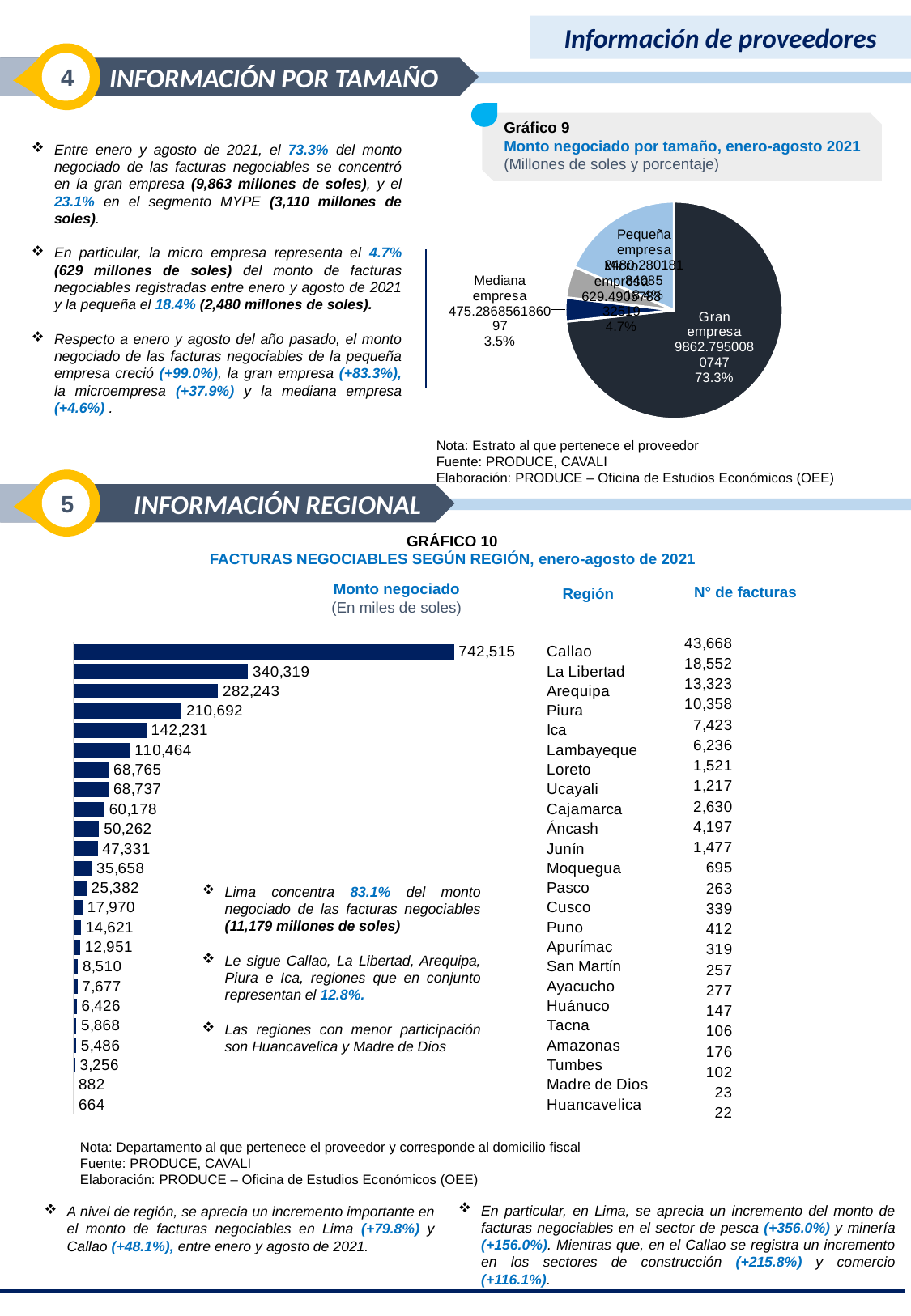
In Gráfico 9, which segment has the largest share? Gran empresa In Gráfico 10, which has a larger monto negociado, Piura or Ica? Piura In Gráfico 9, what percentage share does Mediana empresa have? 3.5% In Gráfico 10, which region has the lowest monto negociado? Huancavelica How many regions are shown in Gráfico 10? 24 In Gráfico 9, what percentage share does Gran empresa have? 73.3% In Gráfico 10, which region has the highest monto negociado? Callao In Gráfico 10, what is the monto negociado for Arequipa? 282,243 In Gráfico 10, what is the difference in monto negociado between Callao and La Libertad? 402,196 In Gráfico 10, what is the monto negociado for Callao? 742,515 What kind of chart is Gráfico 10? Bar chart What kind of chart is Gráfico 9? Pie chart